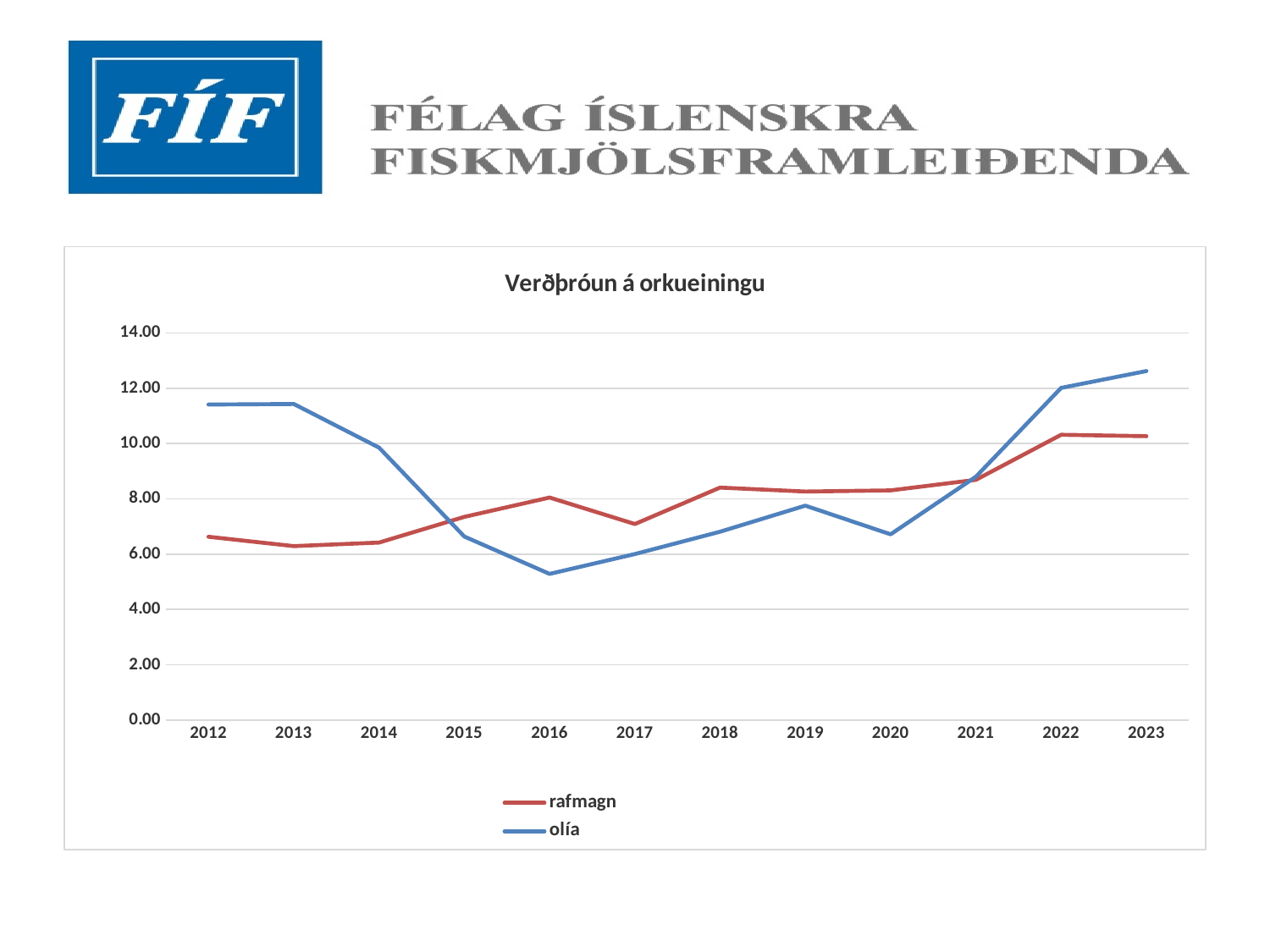
What kind of chart is shown on the slide? line chart How many years are plotted along the x axis? 12 Is the value for rafmagn in 2022 greater or less than 10.00? greater How many series does the legend list? 2 What is the title of the chart? Verðþróun á orkueiningu Is the value for olía in 2016 greater or less than 6.00? less In 2016, which series has the higher value, rafmagn or olía? rafmagn Does the olía series rise or fall from 2012 to 2016? fall In which year is the olía series at its lowest? 2016 In which year is the olía series at its highest? 2023 In 2012, which series has the higher value, rafmagn or olía? olía Is the value for olía in 2023 greater or less than 12.00? greater